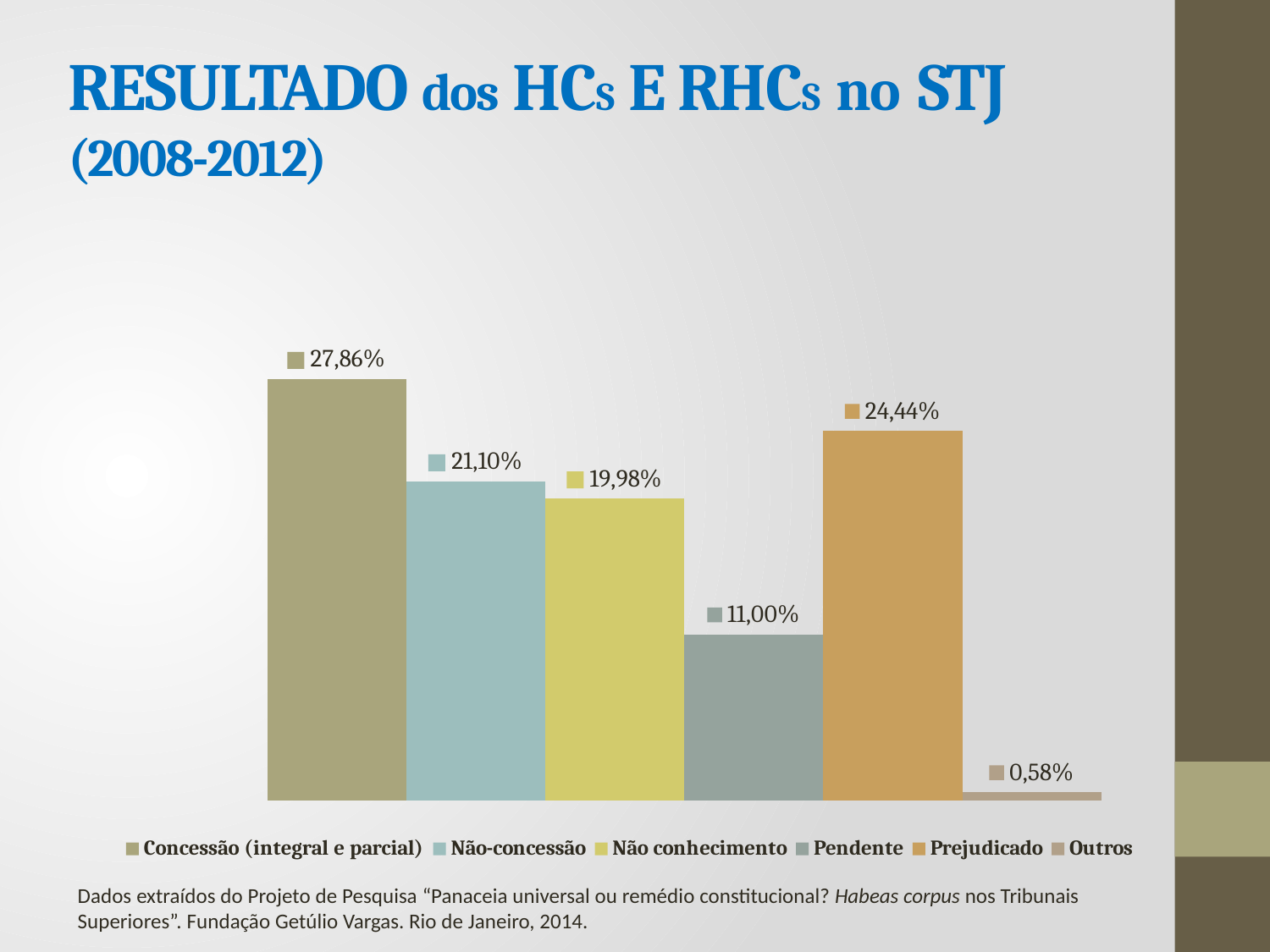
Which is larger, Não-concessão or Não conhecimento? Não-concessão What is the value for Prejudicado? 24,44% What is the value for Pendente? 11,00% What kind of chart is shown on the slide? Bar chart How many entries does the legend list? 6 What is the value for Concessão (integral e parcial)? 27,86% Which category has the highest value? Concessão (integral e parcial) What is the difference between Não-concessão and Não conhecimento? 1,12% What is the value for Outros? 0,58% Which category has the lowest value? Outros How many bars are plotted in the chart? 6 What is the difference between Concessão (integral e parcial) and Prejudicado? 3,42%